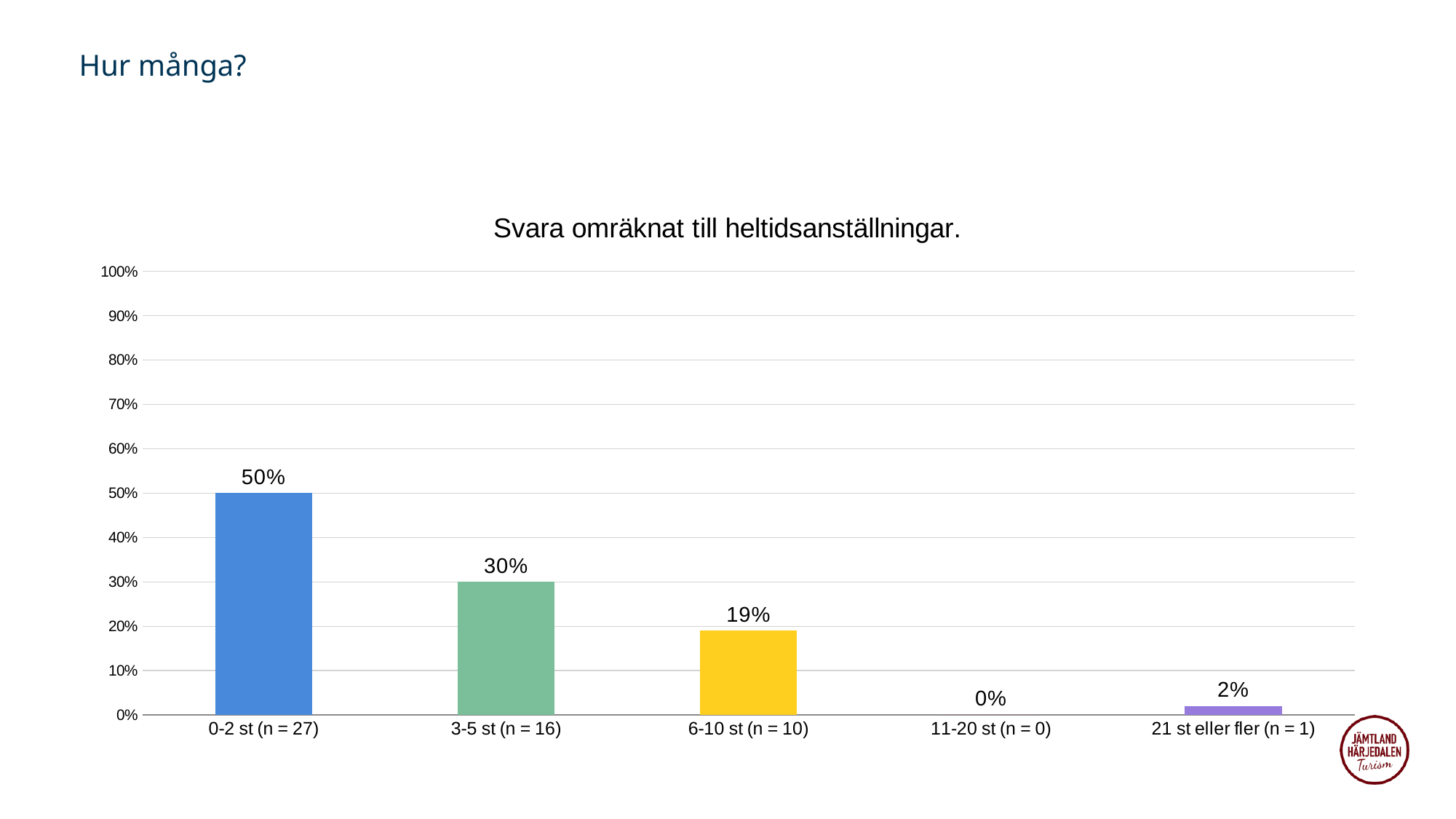
What is the value for the category "3-5 st (n = 16)"? 30% What is the value for the category "21 st eller fler (n = 1)"? 2% What is the difference between the values for "0-2 st (n = 27)" and "3-5 st (n = 16)"? 20% Is the value for "3-5 st (n = 16)" greater or less than 40%? less Which category has the lowest value? 11-20 st (n = 0) What kind of chart is shown on the slide? bar chart What is the title of the chart? Svara omräknat till heltidsanställningar. Which category has the highest value? 0-2 st (n = 27) What is the value for the category "0-2 st (n = 27)"? 50% Which is larger, the value for "6-10 st (n = 10)" or the value for "21 st eller fler (n = 1)"? 6-10 st (n = 10) What is the value for the category "6-10 st (n = 10)"? 19% How many categories are shown on the x axis? 5